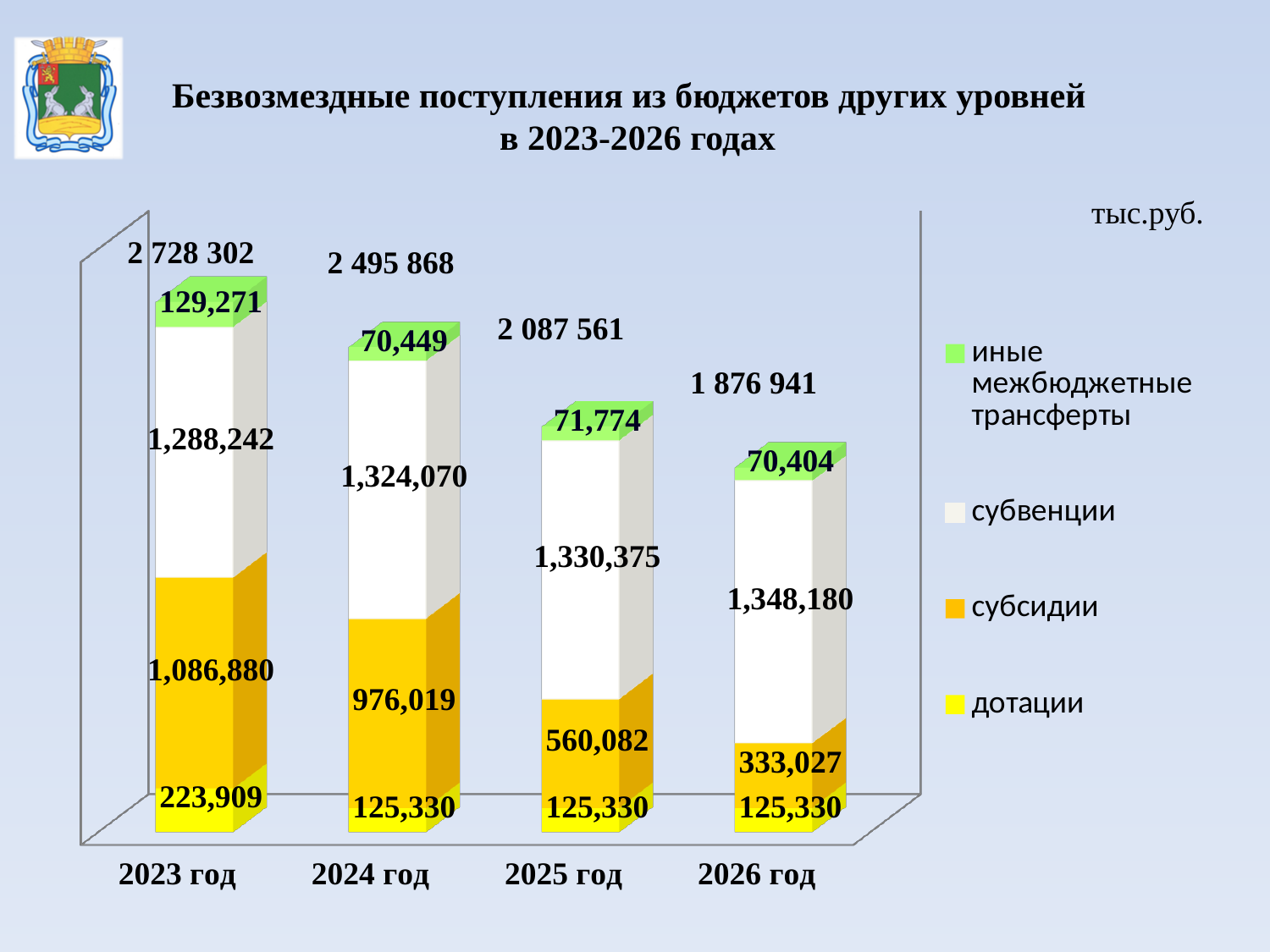
Do the bar totals rise or fall from 2023 год to 2026 год? fall Which year has the highest total of безвозмездные поступления? 2023 год What kind of chart is shown on the slide? stacked bar chart What is the difference between субсидии in 2023 год and 2024 год? 110,861 What is the value of иные межбюджетные трансферты for 2024 год? 70,449 What is the value of субсидии for 2023 год? 1,086,880 Which year has the lowest value of субсидии? 2026 год What is the value of дотации for 2025 год? 125,330 What is the value of субвенции for 2026 год? 1,348,180 What is the total of the stacked bar for 2025 год? 2 087 561 How many series does the legend list? 4 Which is larger: субвенции in 2025 год or субвенции in 2024 год? субвенции in 2025 год